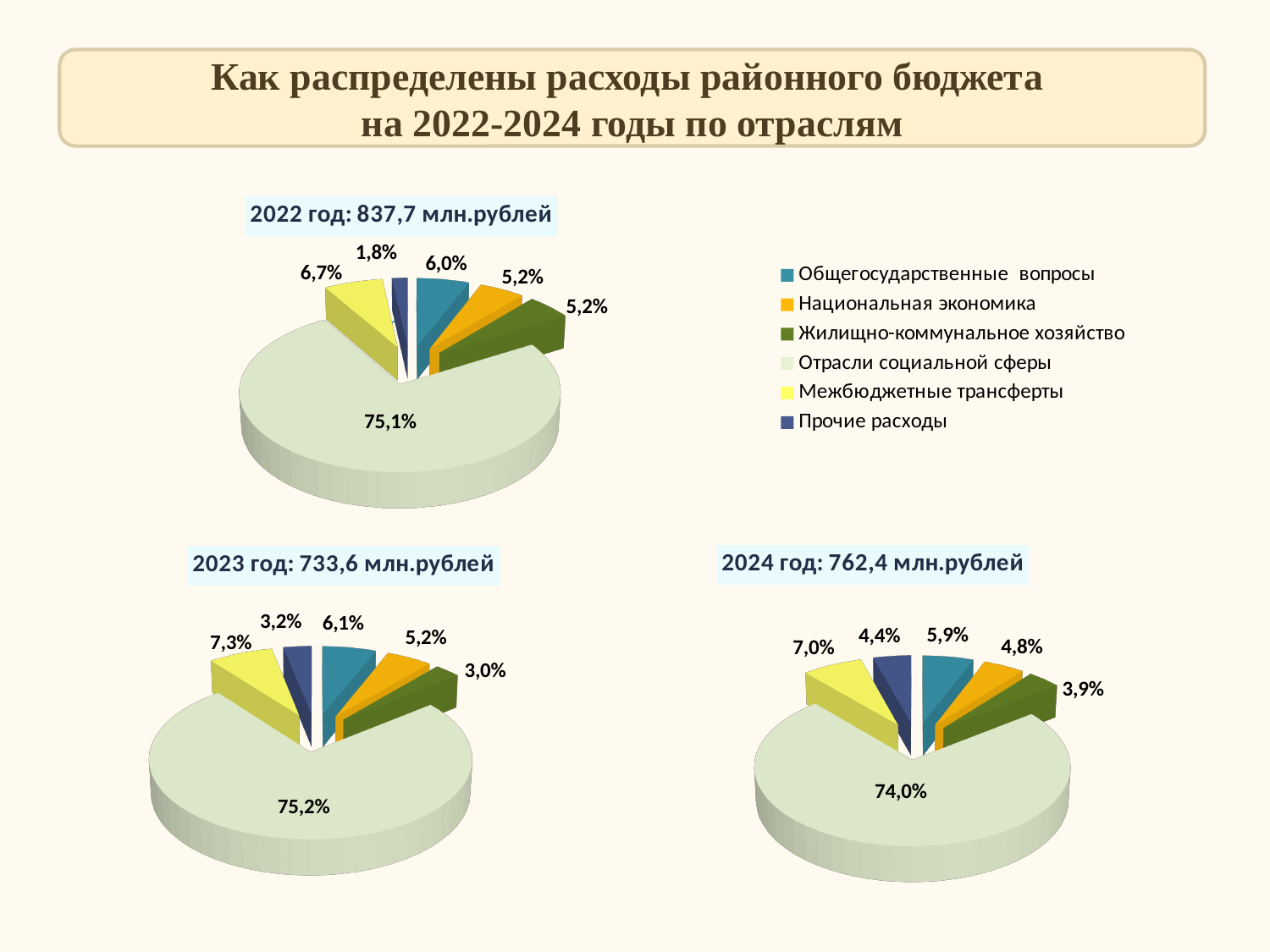
What total amount is given in the title of the 2023 chart? 733,6 млн.рублей In the 2022 pie chart, which category has the smallest share? Прочие расходы In the 2023 pie chart, which category has the largest share? Отрасли социальной сферы How many entries does the legend list? 6 In the 2024 pie chart, what share is labelled for Национальная экономика? 4,8% In the 2023 pie chart, what share is labelled for Межбюджетные трансферты? 7,3% How many slices does the 2022 pie chart have? 6 In the 2024 pie chart, what is the difference between the shares of Межбюджетные трансферты and Жилищно-коммунальное хозяйство? 3,1% In the 2023 pie chart, which is larger: Общегосударственные вопросы or Жилищно-коммунальное хозяйство? Общегосударственные вопросы In the 2022 pie chart, what share is labelled for Отрасли социальной сферы? 75,1% What type of chart is used for the 2024 data? Pie chart In the 2024 pie chart, what share is labelled for Прочие расходы? 4,4%